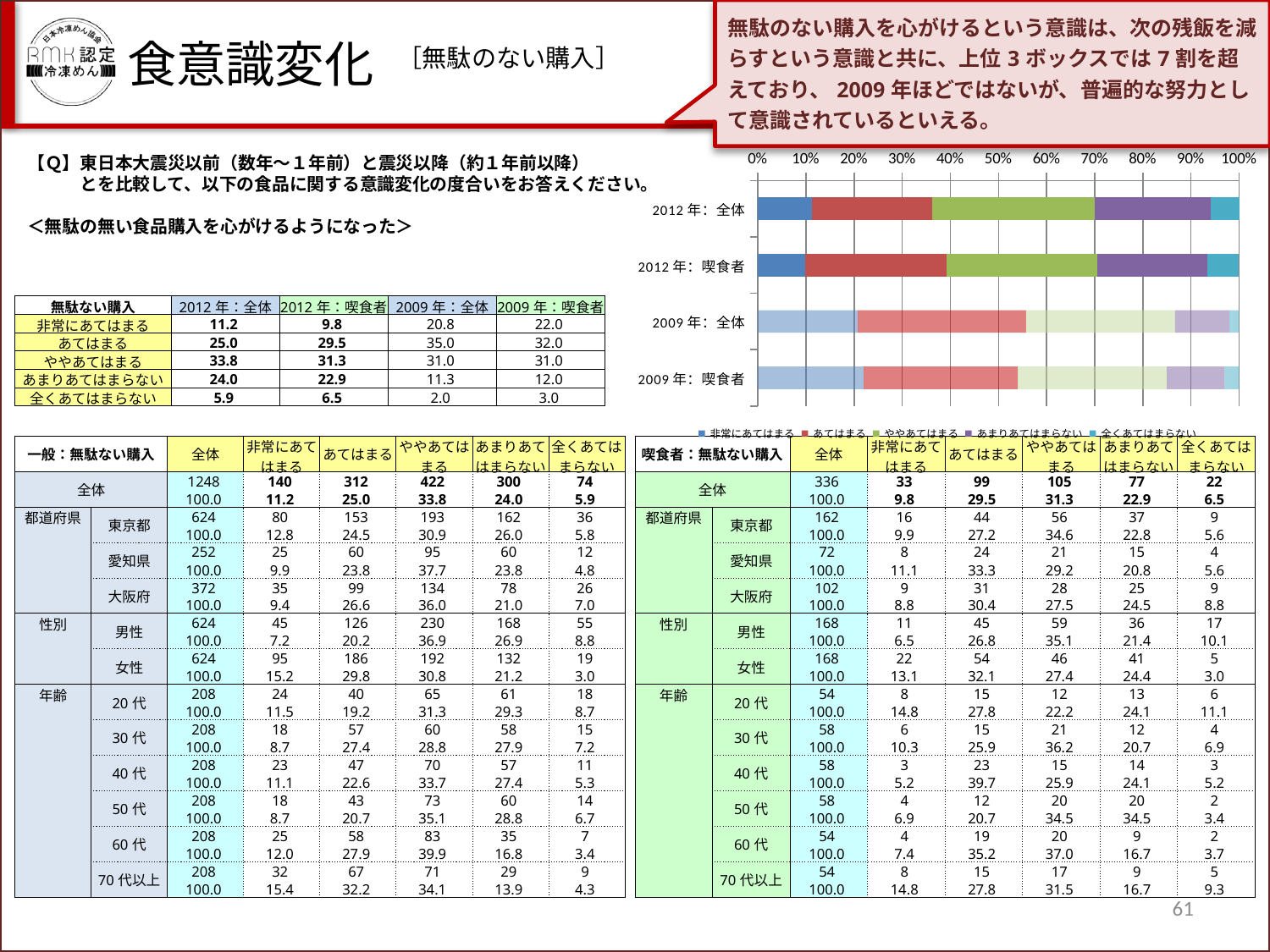
Is the 非常にあてはまる segment for 2009年：喫食者 greater or less than 10%? greater What is the first series listed in the chart's legend? 非常にあてはまる Which bar has the longer あまりあてはまらない segment, 2012年：全体 or 2009年：全体? 2012年：全体 Is the combined share of 非常にあてはまる and あてはまる for 2012年：全体 greater or less than 40%? less Which bar has the longer あてはまる segment, 2012年：喫食者 or 2009年：喫食者? 2009年：喫食者 What is the maximum value shown on the chart's percentage axis? 100% Is the 非常にあてはまる segment for 2009年：全体 greater or less than 10%? greater How many series does the chart's legend list? 5 Which bar has the longer 非常にあてはまる segment, 2012年：全体 or 2009年：全体? 2009年：全体 What kind of chart is shown on the slide? stacked bar chart How many categories (bars) does the chart show? 4